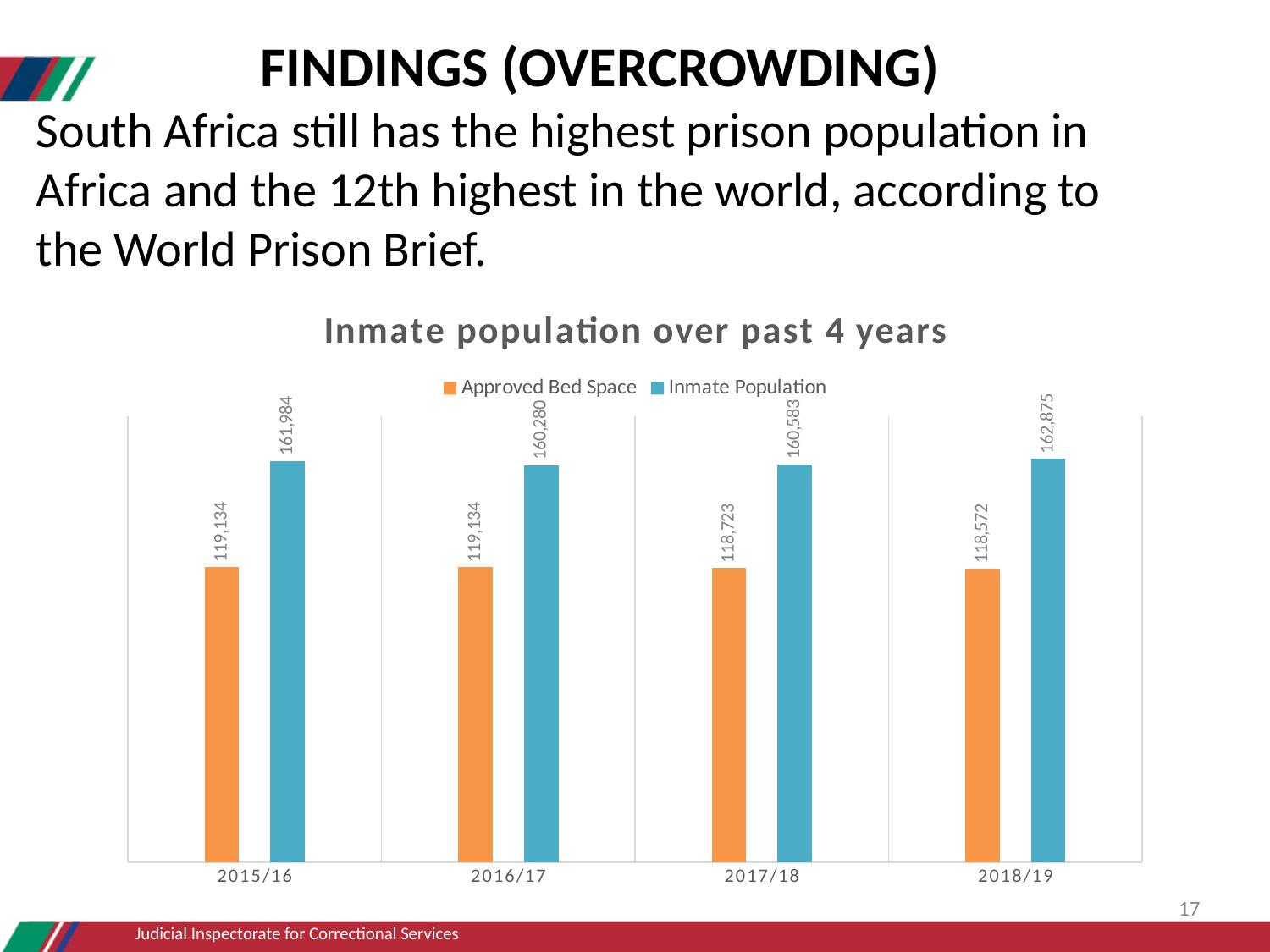
What is the Inmate Population value for 2016/17? 160,280 What type of chart is shown on the slide? Bar chart Which is larger in 2015/16, Approved Bed Space or Inmate Population? Inmate Population What is the Approved Bed Space value for 2015/16? 119,134 How many years are shown on the x axis of the chart? 4 What is the Inmate Population value for 2018/19? 162,875 In which year is the Inmate Population lowest? 2016/17 How many series does the chart's legend list? 2 What is the difference between Inmate Population and Approved Bed Space in 2018/19? 44,303 In which year is the Inmate Population highest? 2018/19 What is the Approved Bed Space value for 2017/18? 118,723 In which year is the Approved Bed Space lowest? 2018/19